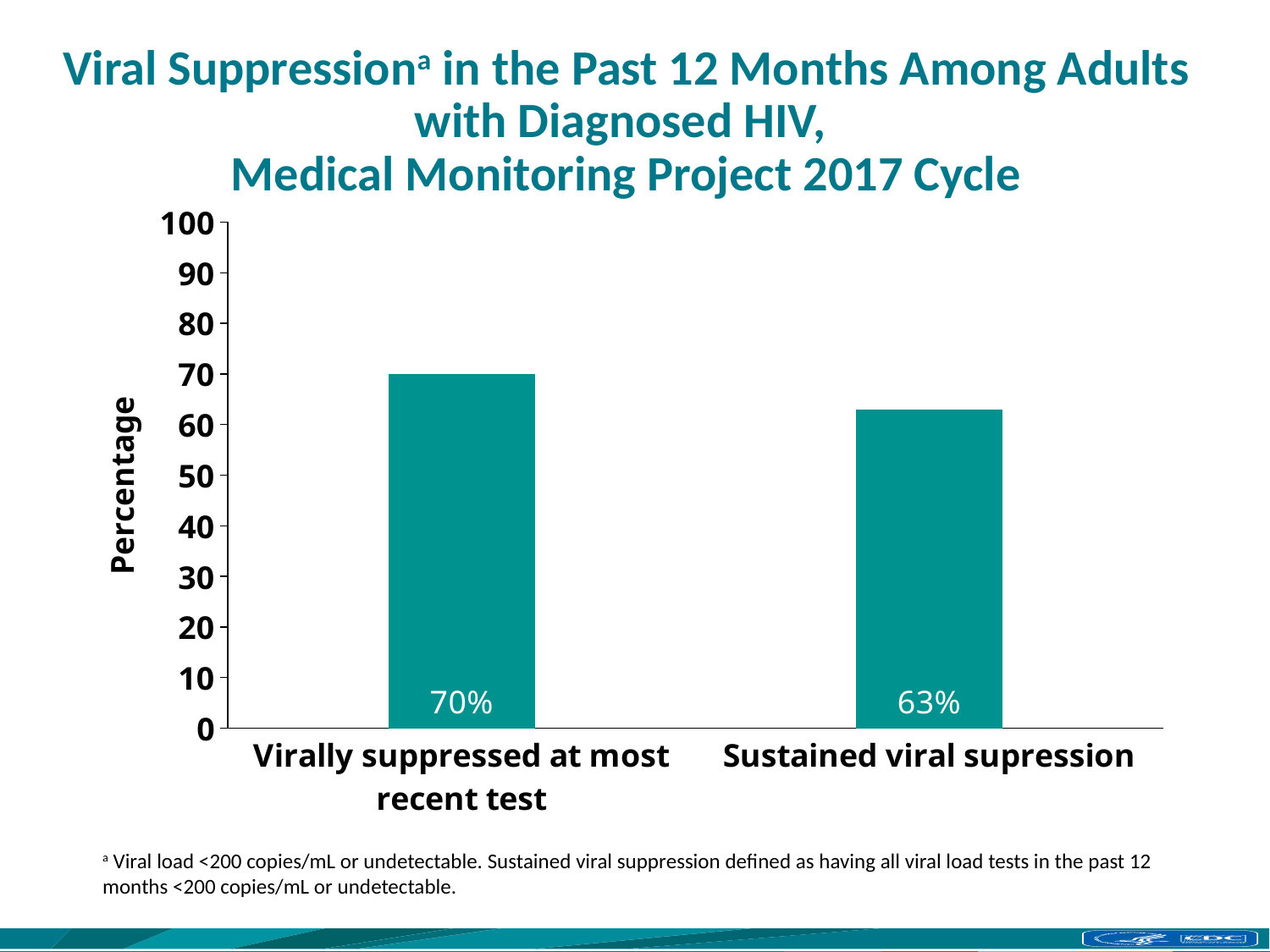
What is the value for 'Virally suppressed at most recent test'? 70% What is the value for 'Sustained viral supression'? 63% What is the difference between the value for 'Virally suppressed at most recent test' and the value for 'Sustained viral supression'? 7% What is the label of the y axis? Percentage What is the maximum value shown on the y axis? 100 Which category has the highest value? Virally suppressed at most recent test Which is larger: the value for 'Virally suppressed at most recent test' or the value for 'Sustained viral supression'? Virally suppressed at most recent test What kind of chart is shown on the slide? bar chart How many categories are shown in the chart? 2 Is the value for 'Virally suppressed at most recent test' greater or less than 60? greater Which category has the lowest value? Sustained viral supression Is the value for 'Sustained viral supression' greater or less than 70? less